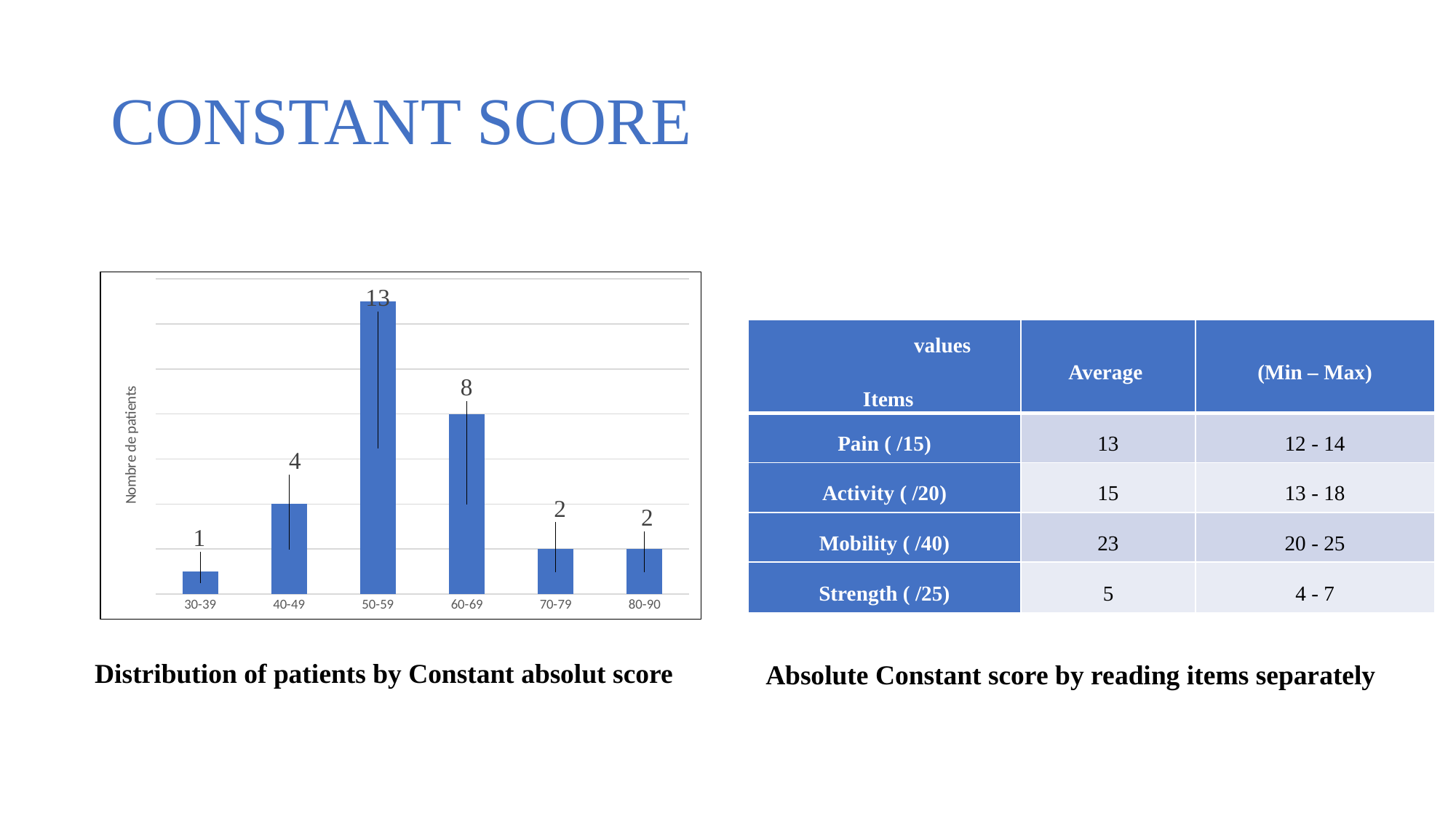
What is the value for the 40-49 category? 4 What is the difference between the values for 40-49 and 30-39? 3 What is the label of the vertical axis of the chart? Nombre de patients What is the value for the 60-69 category? 8 Which score range has the highest number of patients? 50-59 How many score-range categories are shown on the x axis of the chart? 6 What kind of chart is shown on the slide? Bar chart What is the difference between the values for 50-59 and 60-69? 5 Which score range has the lowest number of patients? 30-39 How many patients are in the 50-59 score range? 13 What is the value for the 30-39 category? 1 Which is larger, the value for 40-49 or the value for 70-79? 40-49